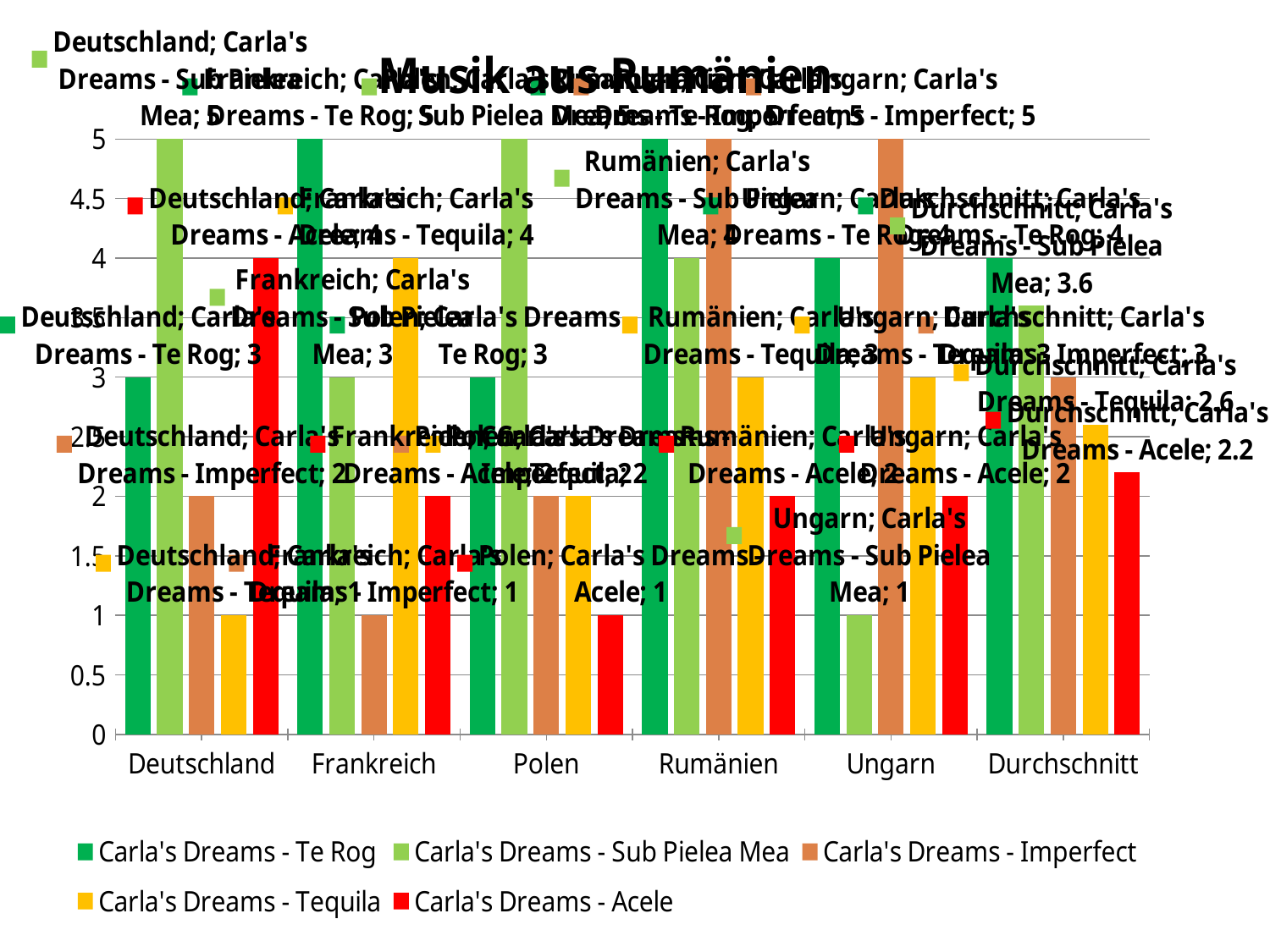
How many categories are shown on the x axis? 6 What is the value for Carla's Dreams - Sub Pielea Mea in the Ungarn category? 1 Which is larger in the Deutschland category: Carla's Dreams - Acele or Carla's Dreams - Tequila? Carla's Dreams - Acele What is the value for Carla's Dreams - Acele in the Deutschland category? 4 What is the value for Carla's Dreams - Tequila in the Durchschnitt category? 2.6 How many series does the legend list? 5 What is the value for Carla's Dreams - Acele in the Durchschnitt category? 2.2 Which series has the highest value in the Durchschnitt category? Carla's Dreams - Te Rog What is the difference between Carla's Dreams - Te Rog and Carla's Dreams - Acele in the Durchschnitt category? 1.8 What is the value for Carla's Dreams - Sub Pielea Mea in the Durchschnitt category? 3.6 What type of chart is shown on the slide? bar chart What is the value for Carla's Dreams - Acele in the Polen category? 1